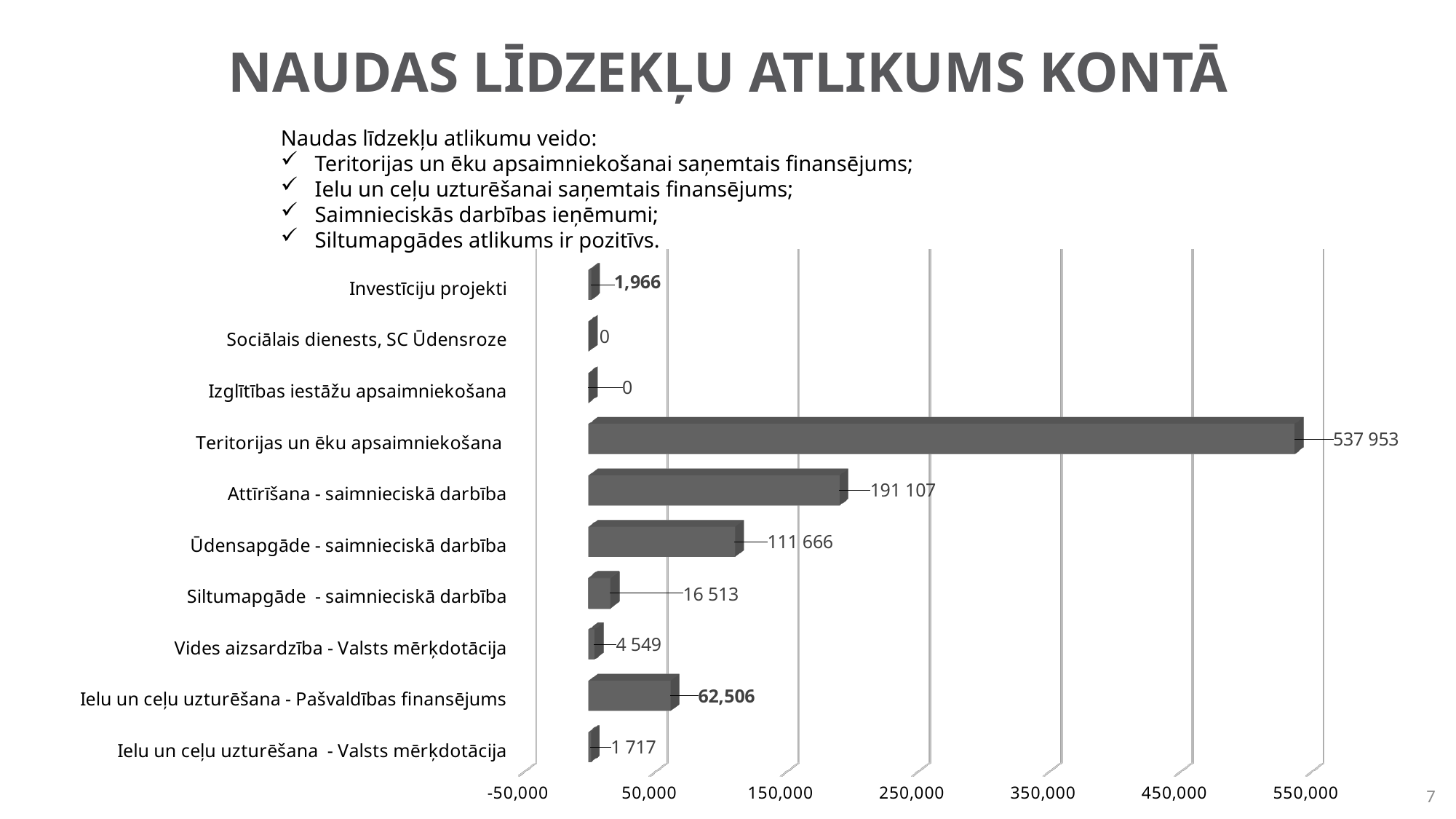
What type of chart is shown on the slide? bar chart How many categories are shown in the chart? 10 Which is larger, Ūdensapgāde - saimnieciskā darbība or Ielu un ceļu uzturēšana - Pašvaldības finansējums? Ūdensapgāde - saimnieciskā darbība What is the value for Attīrīšana - saimnieciskā darbība? 191 107 What is the difference between Attīrīšana - saimnieciskā darbība and Ūdensapgāde - saimnieciskā darbība? 79 441 Is the value for Teritorijas un ēku apsaimniekošana greater or less than 450,000? greater What is the difference between Teritorijas un ēku apsaimniekošana and Attīrīšana - saimnieciskā darbība? 346 846 What is the value for Siltumapgāde - saimnieciskā darbība? 16 513 What is the value for Investīciju projekti? 1,966 Which category has the highest value? Teritorijas un ēku apsaimniekošana What is the value for Ielu un ceļu uzturēšana - Pašvaldības finansējums? 62,506 What is the value for Teritorijas un ēku apsaimniekošana? 537 953